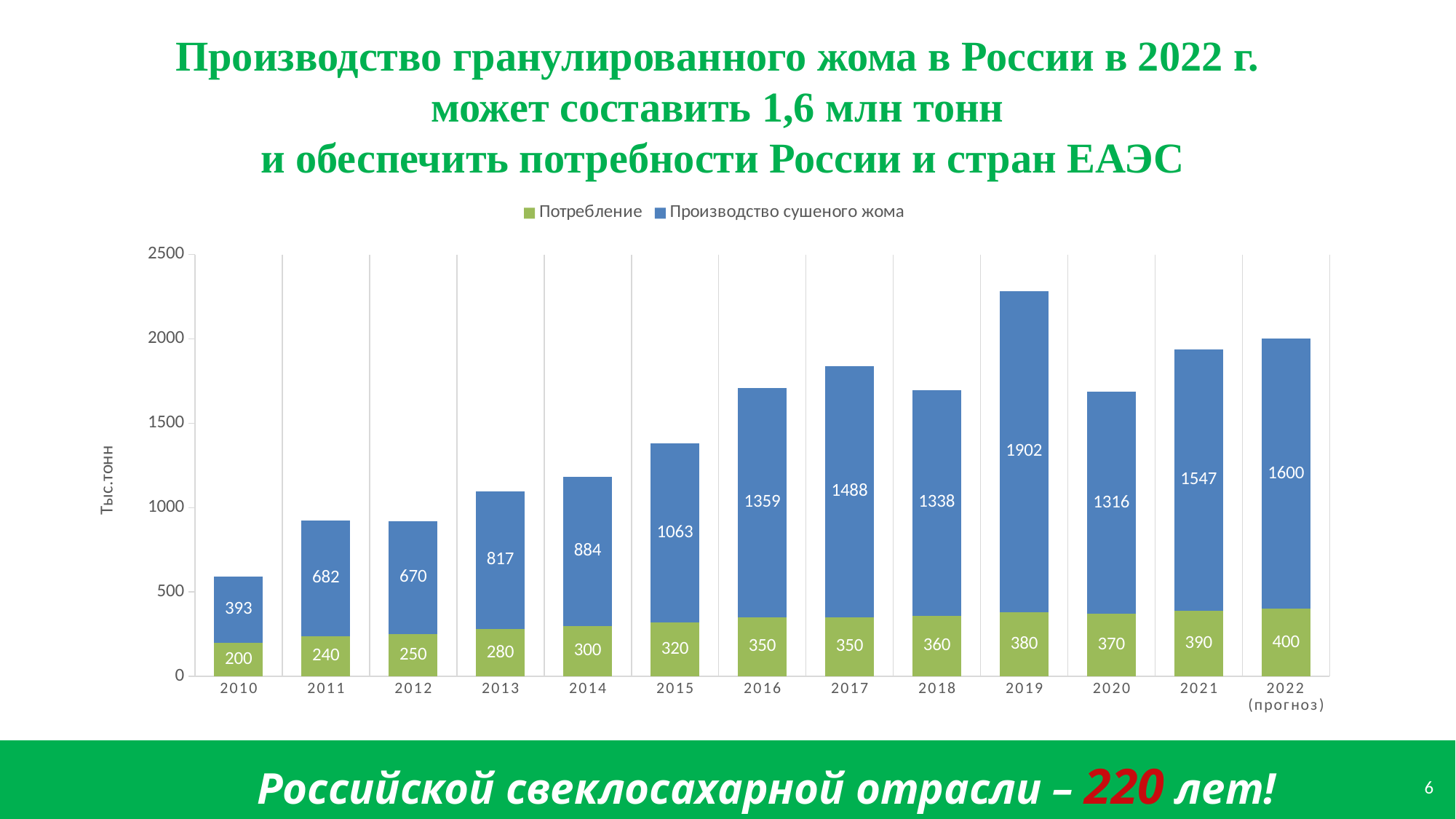
In which year is Потребление the lowest? 2010 Which year has the larger value of Производство сушеного жома, 2013 or 2014? 2014 How many series does the legend list? 2 Does Потребление rise or fall from 2010 to 2022? Rises How many years are shown on the x axis? 13 What is the total height of the stacked bar for 2019? 2282 What is the value of Производство сушеного жома for 2019? 1902 What is the value of Потребление for 2015? 320 What kind of chart is shown on the slide? Stacked bar chart In which year is Производство сушеного жома the highest? 2019 What is the total height of the stacked bar for 2022 (прогноз)? 2000 What is the difference between Производство сушеного жома in 2021 and in 2020? 231